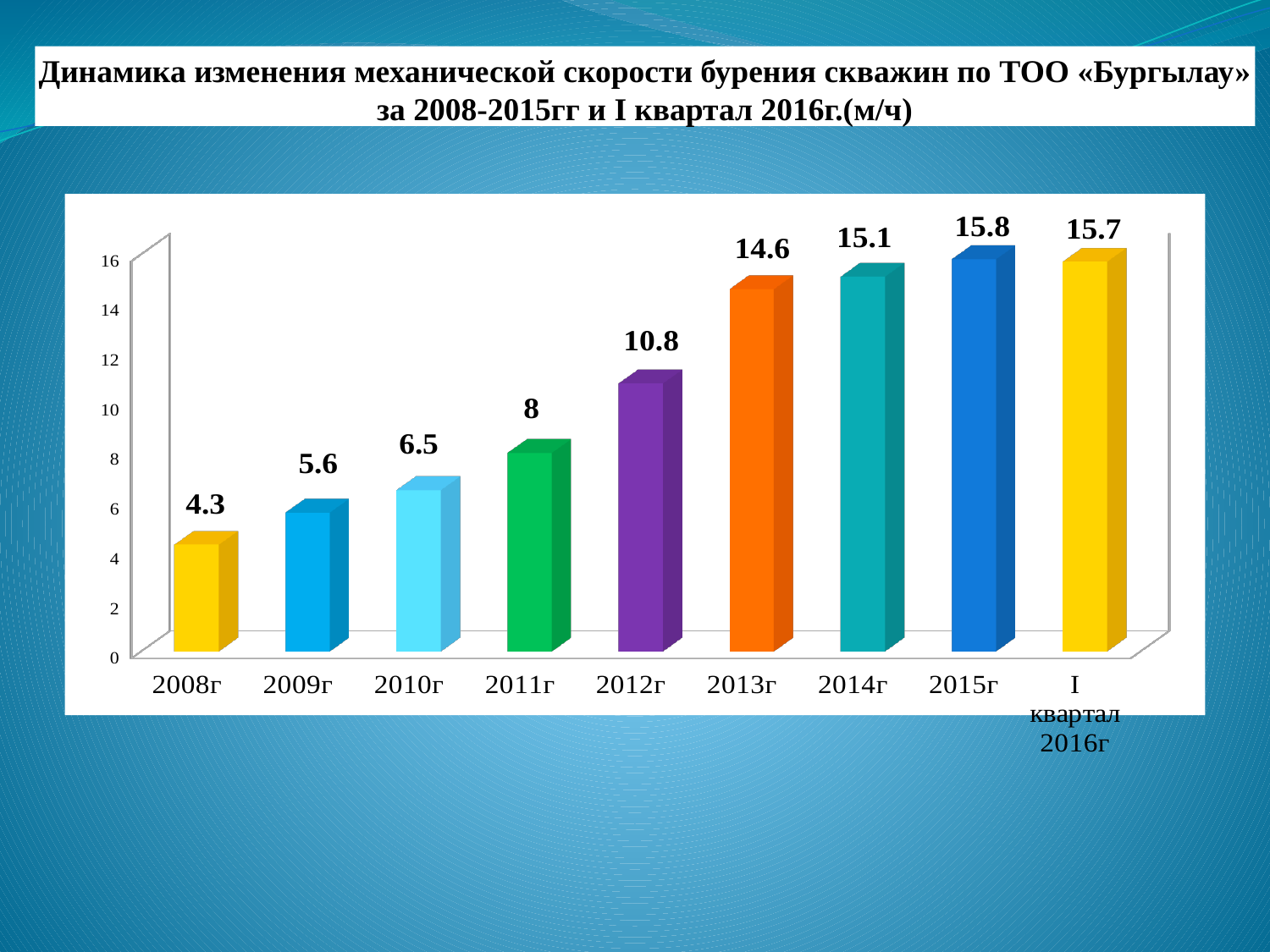
What value is shown for I квартал 2016г? 15.7 Which is larger, the value for 2010г or the value for 2011г? 2011г What unit is given in the chart title for the drilling speed? м/ч Which category has the highest value? 2015г What value is shown for 2012г? 10.8 What is the difference between the values for 2015г and 2008г? 11.5 What kind of chart is shown on the slide? bar chart Do the values generally rise or fall from 2008г to 2015г? rise How many categories are shown on the x axis? 9 What is the mechanical drilling speed value shown for 2008г? 4.3 Which category has the lowest value? 2008г What is the difference between the values for 2013г and 2012г? 3.8